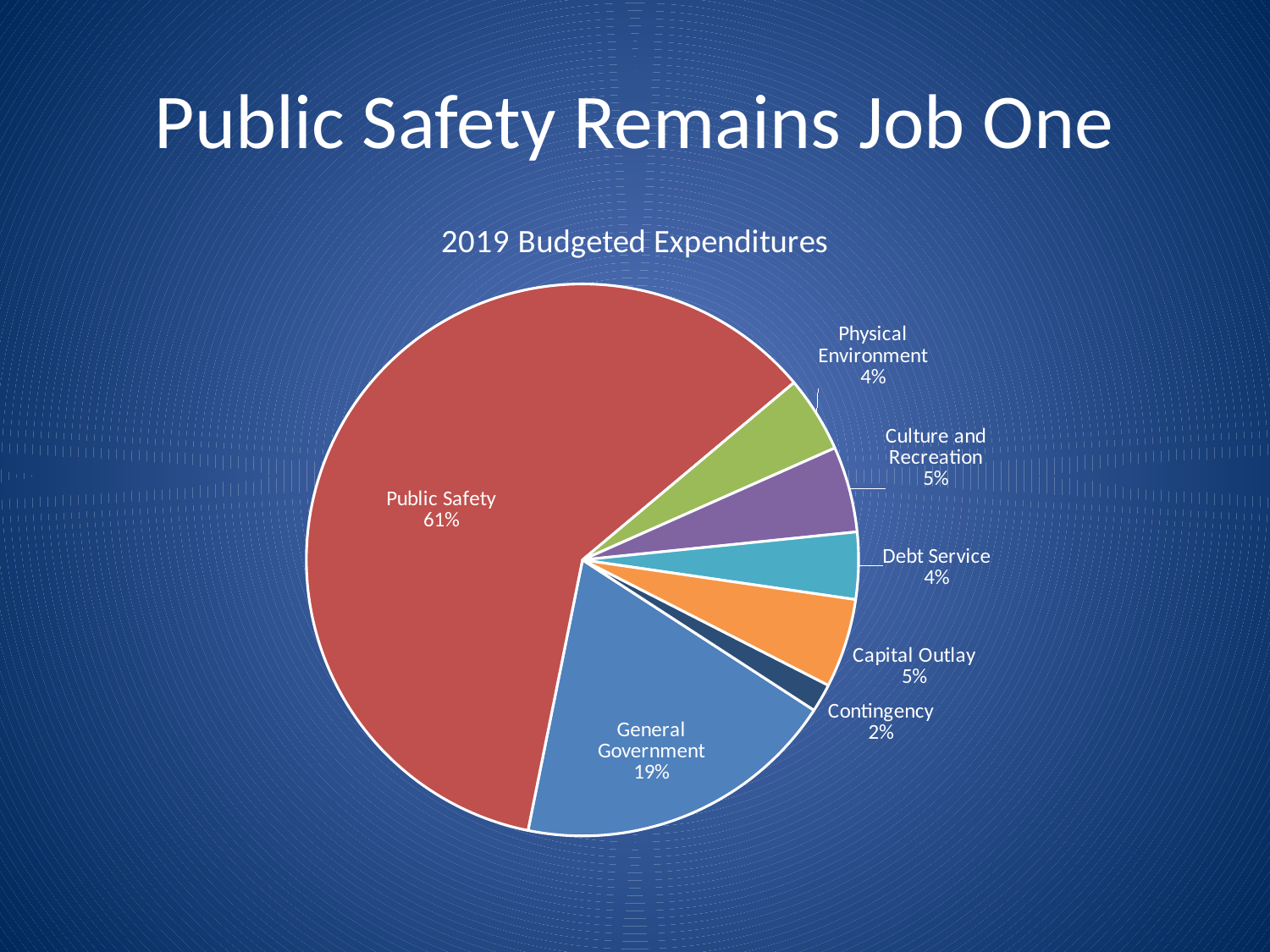
What percentage is labelled for Debt Service? 4% What share of 2019 Budgeted Expenditures goes to Public Safety? 61% What is the difference in percentage points between Public Safety and General Government? 42 What is the title of the chart? 2019 Budgeted Expenditures What colour is the Public Safety slice? Red What is the value shown for Contingency? 2% Which is larger, General Government or Capital Outlay? General Government What percentage of the pie is General Government? 19% Which category has the smallest slice of the pie? Contingency How many categories are shown in the pie chart? 7 What type of chart is shown on the slide? Pie chart Which category has the largest slice of the pie? Public Safety